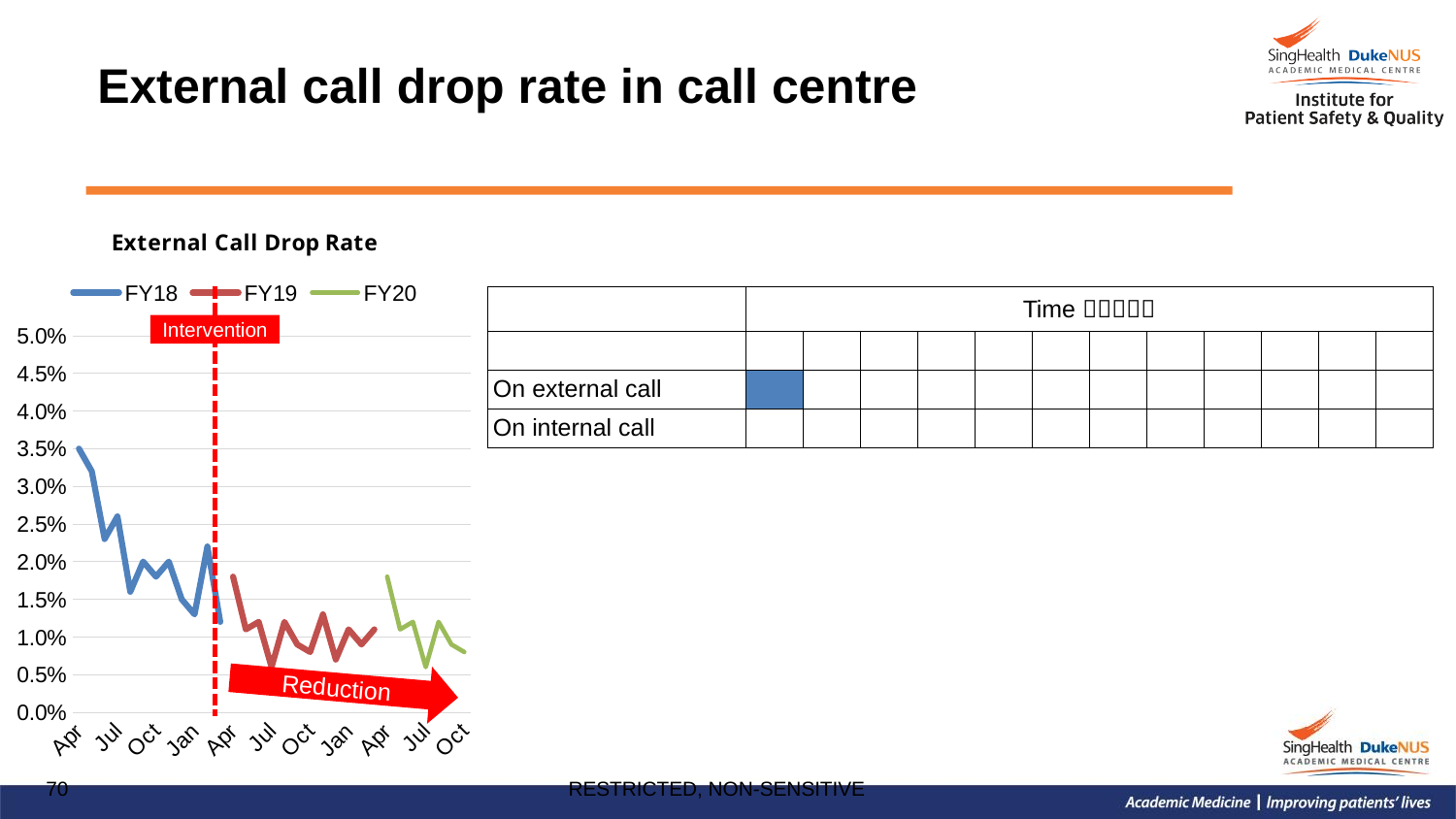
Which series are listed in the legend of the External Call Drop Rate chart? FY18, FY19, FY20 Are the FY19 values in the External Call Drop Rate chart greater or less than 2.0%? less What kind of chart is the External Call Drop Rate chart? Line chart What is the highest value shown on the y axis of the External Call Drop Rate chart? 5.0% How many series does the legend of the External Call Drop Rate chart list? 3 Is the last FY20 value (Oct) in the External Call Drop Rate chart greater or less than 1.0%? less Which series in the External Call Drop Rate chart has the highest values? FY18 What colour is the FY19 line in the External Call Drop Rate chart? Red Overall, do the values in the External Call Drop Rate chart rise or fall along the x axis? Fall Is the first FY18 value (Apr) in the External Call Drop Rate chart greater or less than 3.0%? greater Is the first FY18 value greater or less than the first FY20 value in the External Call Drop Rate chart? greater